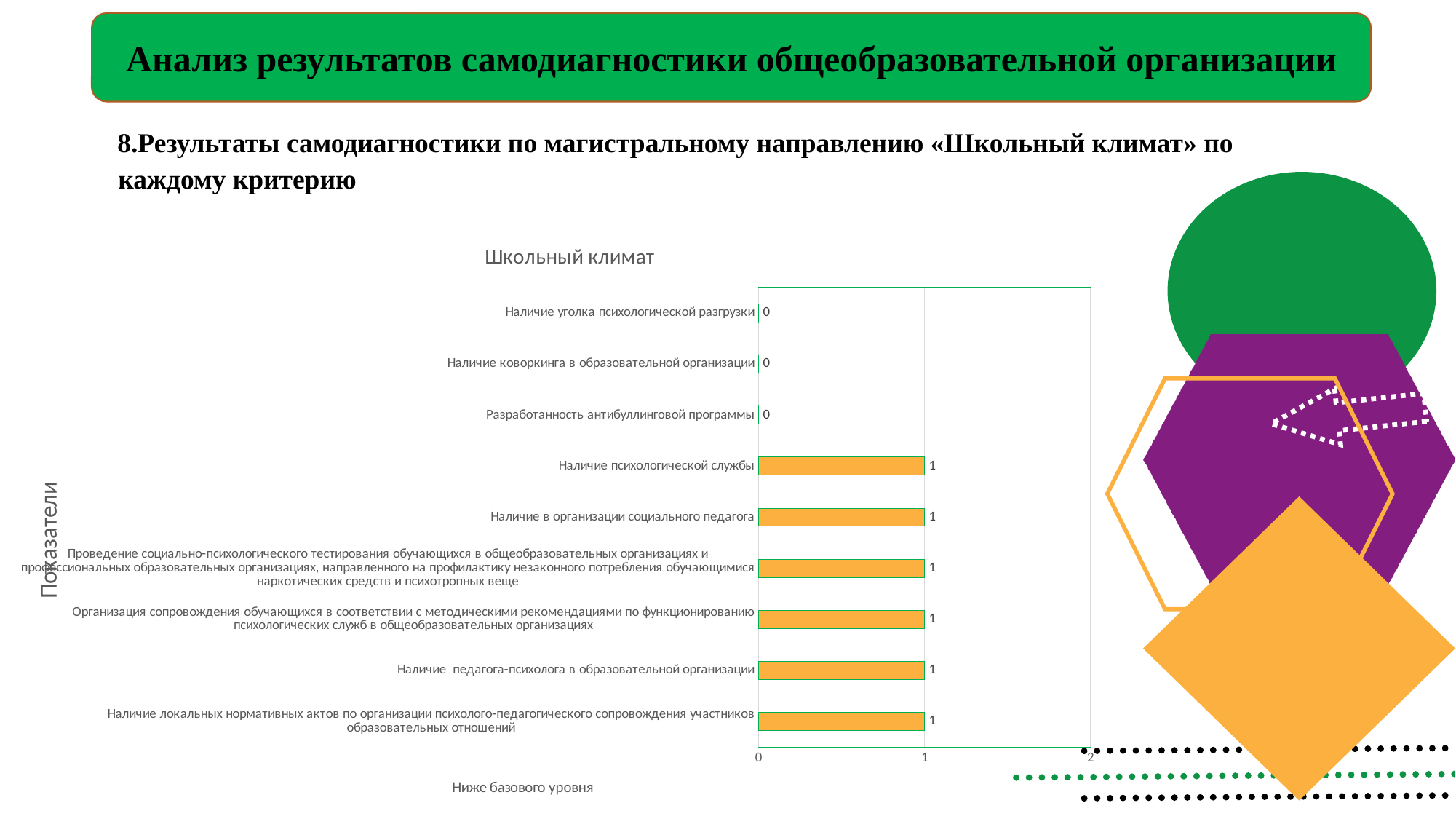
What is the value for "Наличие коворкинга в образовательной организации"? 0 How many categories are plotted in the chart? 9 What is the value for "Наличие психологической службы"? 1 What is the difference between the value for "Наличие психологической службы" and the value for "Наличие уголка психологической разгрузки"? 1 Which is larger: the value for "Наличие в организации социального педагога" or the value for "Наличие уголка психологической разгрузки"? Наличие в организации социального педагога What is the value for "Разработанность антибуллинговой программы"? 0 What is the value for "Наличие педагога-психолога в образовательной организации"? 1 What is the label on the vertical axis of the chart? Показатели What is the title of the chart? Школьный климат What type of chart is shown on the slide? bar chart Is the value for "Наличие психологической службы" greater or less than 2? less How many categories have a value of 0? 3